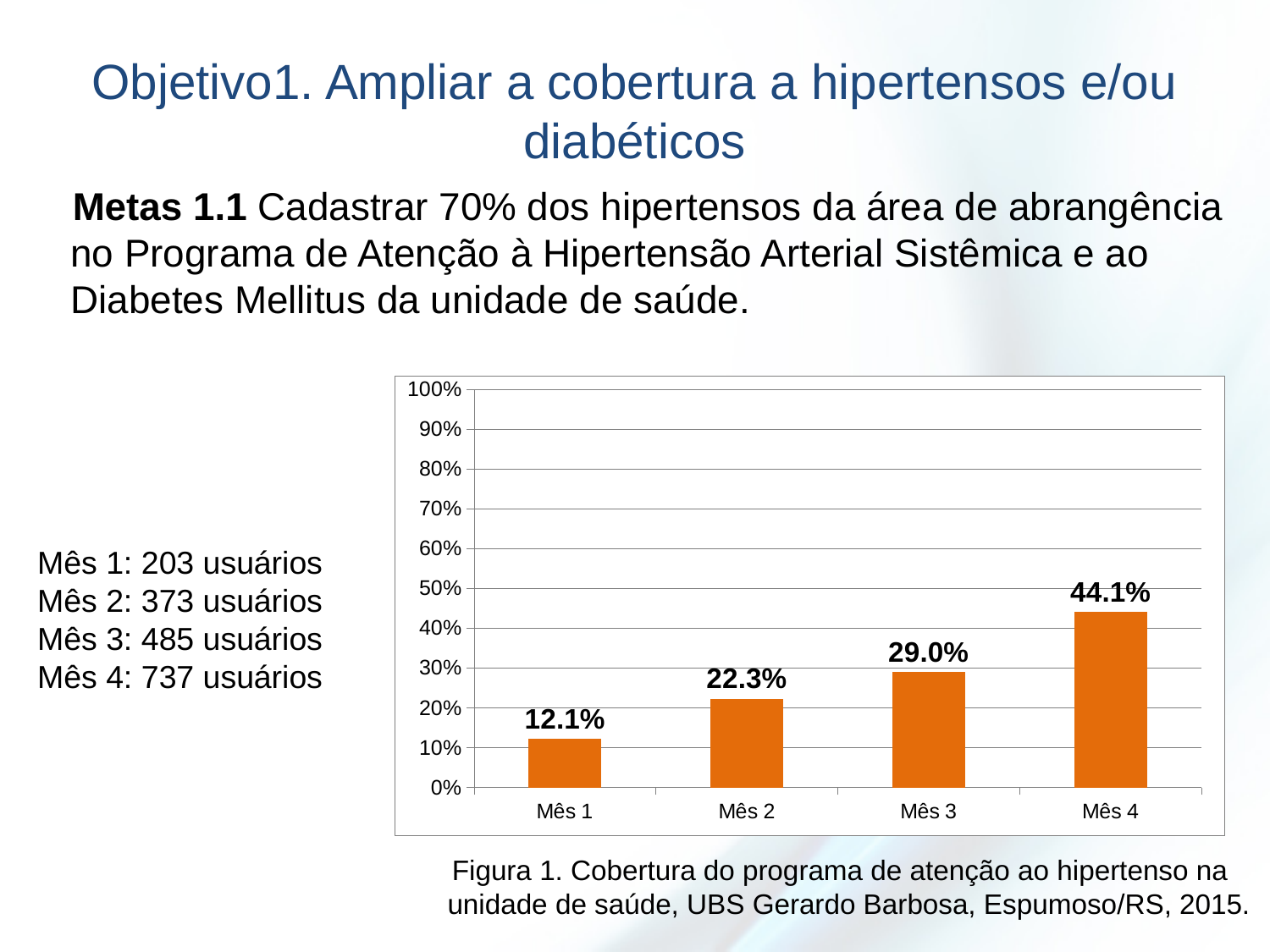
What is the value for Mês 4? 44.1% Which month has the lowest value? Mês 1 What is the difference between the values for Mês 4 and Mês 3? 15.1% Do the values rise or fall from Mês 1 to Mês 4? rise What is the difference between the values for Mês 2 and Mês 1? 10.2% Is the value for Mês 4 greater or less than 50%? less How many months are shown on the x axis? 4 What is the value for Mês 1? 12.1% Which month has the highest value? Mês 4 Which is larger, the value for Mês 2 or the value for Mês 3? Mês 3 What is the value for Mês 3? 29.0% What kind of chart is shown? bar chart